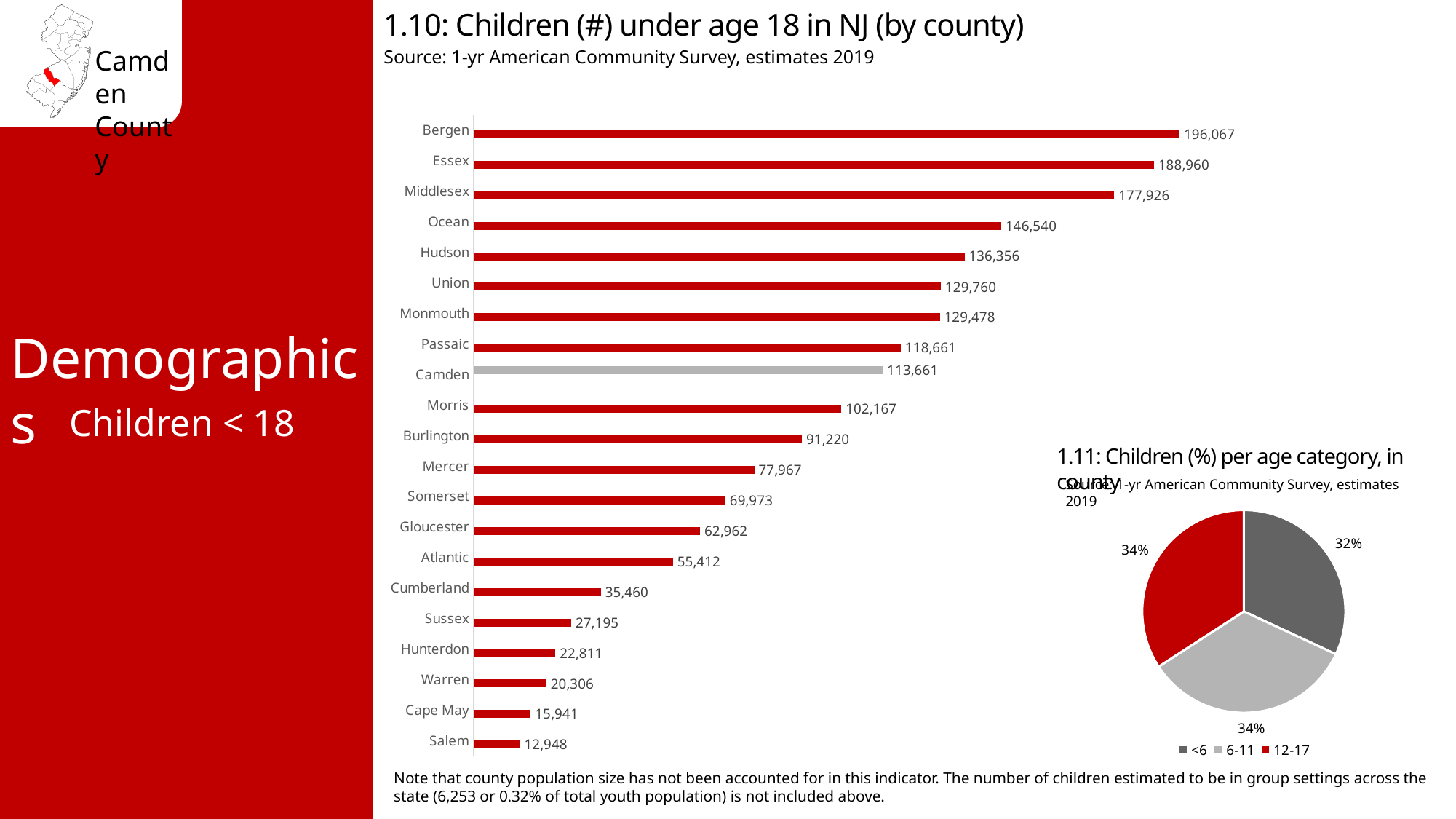
In chart 1.10 (Children under age 18 in NJ by county), which county has the lowest value? Salem In chart 1.11 (Children % per age category, in county), which category is shown in red? 12-17 In chart 1.11 (Children % per age category, in county), what share of the pie is the <6 category? 32% In chart 1.10 (Children under age 18 in NJ by county), what is the difference between Bergen and Essex? 7,107 In chart 1.10 (Children under age 18 in NJ by county), what is the difference between Gloucester and Atlantic? 7,550 In chart 1.11 (Children % per age category, in county), how many categories does the legend list? 3 What kind of chart is chart 1.10 (Children under age 18 in NJ by county)? Bar chart In chart 1.10 (Children under age 18 in NJ by county), what is the value for Camden? 113,661 In chart 1.10 (Children under age 18 in NJ by county), which county has the highest value? Bergen In chart 1.10 (Children under age 18 in NJ by county), what is the value for Ocean? 146,540 In chart 1.10 (Children under age 18 in NJ by county), which is larger, Passaic or Camden? Passaic In chart 1.10 (Children under age 18 in NJ by county), how many counties are shown? 21